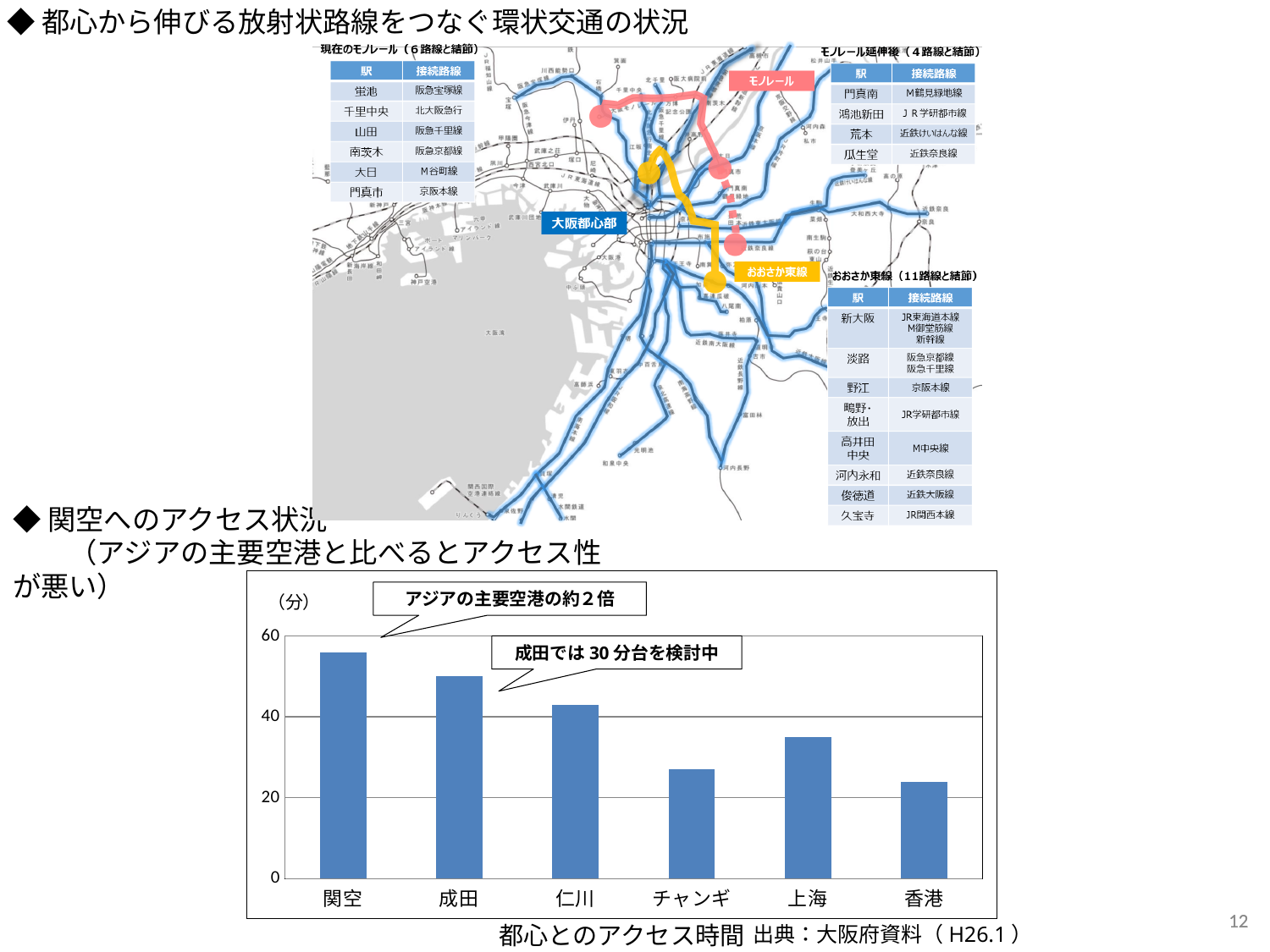
What unit is shown at the top of the y axis of the bar chart? 分 Is the value for チャンギ greater or less than 40? less What kind of chart is shown at the bottom of the slide? bar chart Which airport has the highest access time in the bar chart? 関空 Is the value for 香港 greater or less than 20? greater What does the annotation box pointing to the 関空 bar say? アジアの主要空港の約２倍 Which has the larger value in the bar chart, 関空 or 成田? 関空 Is the value for 関空 greater or less than 40? greater How many airports are shown on the x axis of the bar chart? 6 Which airport has the lowest access time in the bar chart? 香港 Which has the larger value in the bar chart, 上海 or チャンギ? 上海